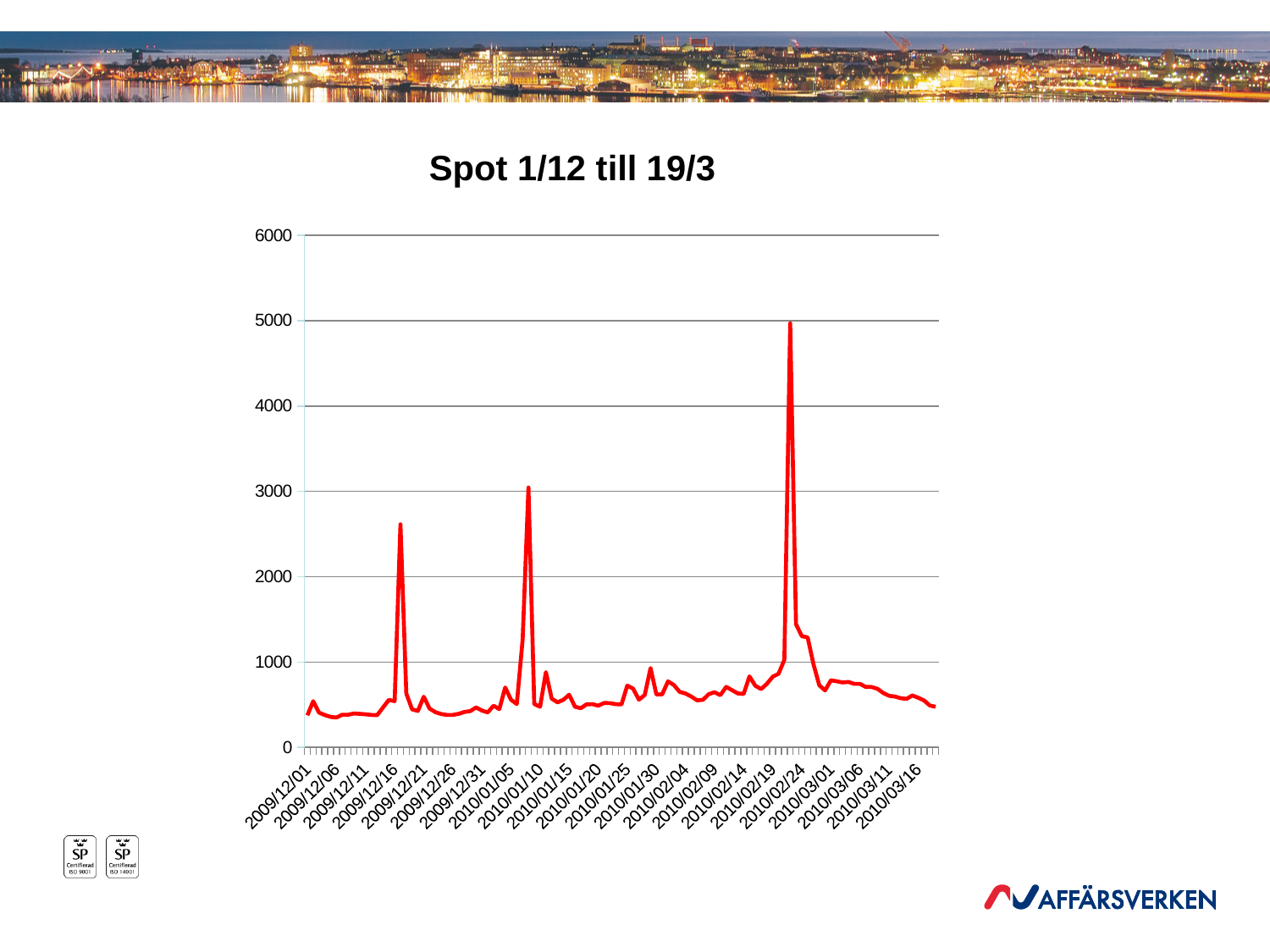
What colour is the plotted line? red Which peak is higher: the one in mid-December 2009 or the one in early January 2010? early January 2010 How many spikes in the line rise above 2000? 3 Is the peak in early January 2010 greater or less than 2000? greater In which month does the highest peak of the line occur? February 2010 Is the peak in mid-December 2009 greater or less than 3000? less What kind of chart is shown on the slide? line chart Is the value at the start of the series, 2009/12/01, greater or less than 1000? less Do the values rise or fall between 2010/03/01 and 2010/03/16? fall What is the title of the chart? Spot 1/12 till 19/3 What is the highest value shown on the y axis? 6000